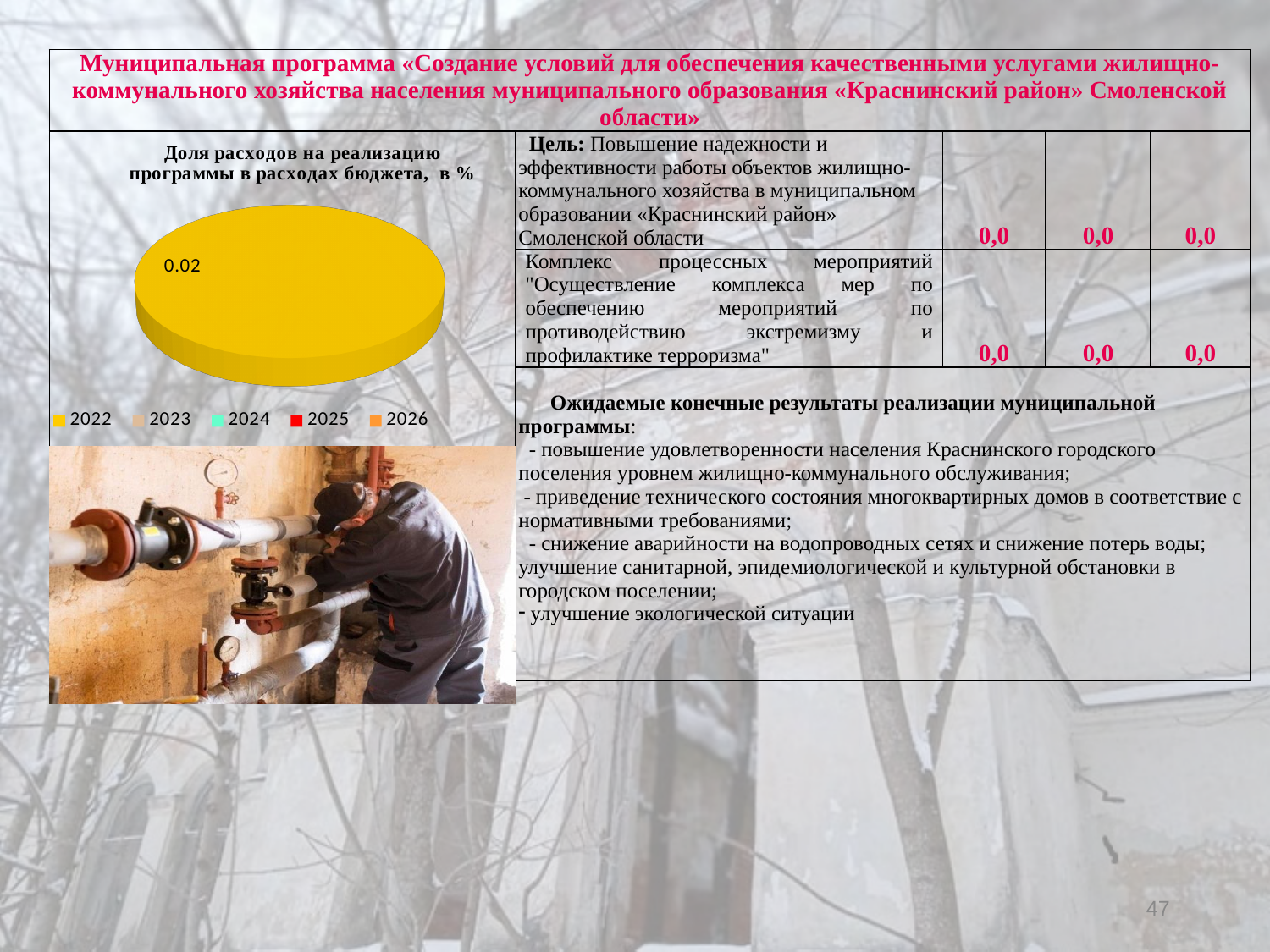
What share of the pie does the 2022 slice occupy? 100% Which year has the largest slice in the pie chart? 2022 What is the title of the chart on the slide? Доля расходов на реализацию программы в расходах бюджета, в % What value is labelled on the pie chart? 0.02 How many entries does the chart legend list? 5 What is the value shown for 2022 in the pie chart? 0.02 Which years are listed in the chart legend? 2022, 2023, 2024, 2025, 2026 What kind of chart is shown on the slide? pie chart How many data labels are printed on the pie chart? 1